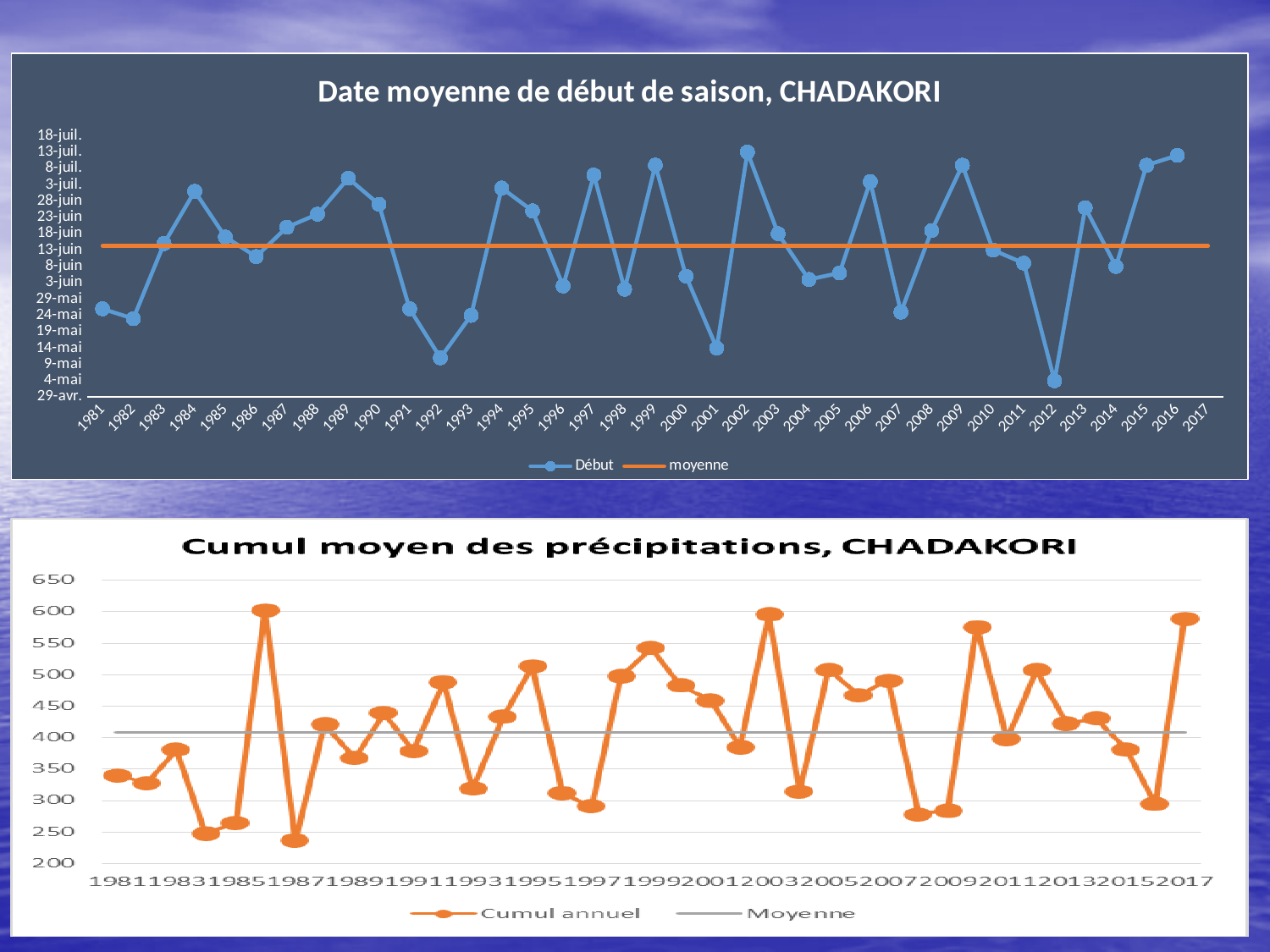
In the bottom chart (Cumul moyen des précipitations), which year has the larger Cumul annuel value, 1986 or 1987? 1986 What is the title of the bottom chart? Cumul moyen des précipitations, CHADAKORI In the bottom chart (Cumul moyen des précipitations), is the Cumul annuel value for 2008 greater or less than 300? less What type of chart is the top chart titled "Date moyenne de début de saison, CHADAKORI"? line chart In the top chart (Date moyenne de début de saison), which year has the earliest (lowest) Début value? 2012 In the top chart (Date moyenne de début de saison), which year has the later Début date, 1984 or 1992? 1984 In the bottom chart (Cumul moyen des précipitations), does the Cumul annuel value rise or fall from 1997 to 1999? rise How many series does the legend of the top chart (Date moyenne de début de saison) list? 2 What are the two legend entries of the top chart (Date moyenne de début de saison)? Début and moyenne In the top chart (Date moyenne de début de saison), does the Début value rise or fall from 1989 to 1992? fall How many series does the legend of the bottom chart (Cumul moyen des précipitations) list? 2 In the bottom chart (Cumul moyen des précipitations), is the Cumul annuel value for 1986 greater or less than 550? greater